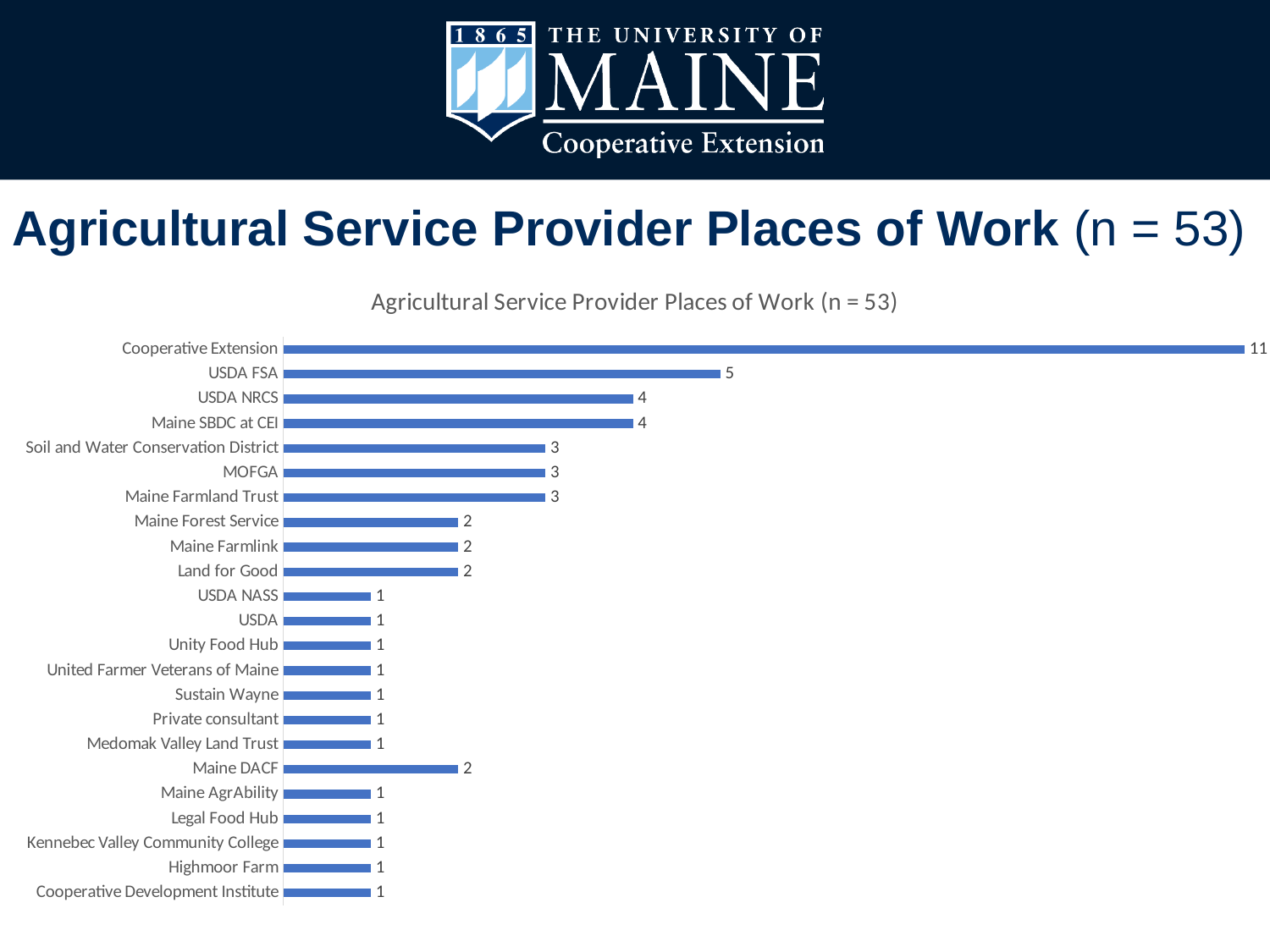
How many places of work are shown in the chart? 23 What is the value for Maine DACF? 2 What is the title of the chart? Agricultural Service Provider Places of Work (n = 53) What is the difference between the values for USDA NRCS and Land for Good? 2 Which is larger, the value for USDA FSA or the value for Maine SBDC at CEI? USDA FSA Which is larger, the value for MOFGA or the value for Maine Forest Service? MOFGA Which place of work has the highest value? Cooperative Extension What is the value for Cooperative Extension? 11 What is the value for USDA FSA? 5 What kind of chart is shown on the slide? Bar chart What is the difference between the values for Cooperative Extension and USDA FSA? 6 What is the value for Soil and Water Conservation District? 3